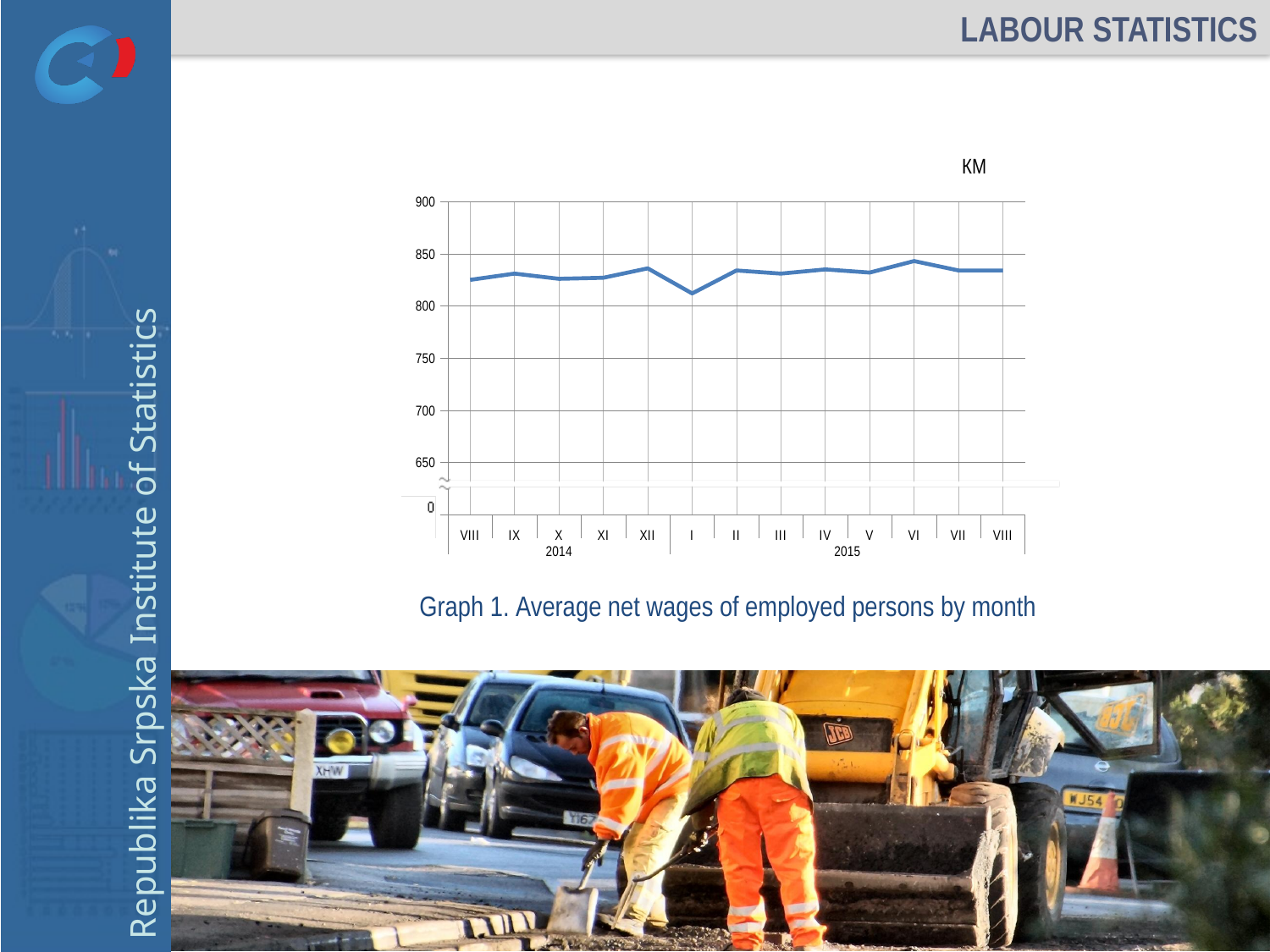
Is the value for VIII 2014 greater or less than 850? less What is the title of the chart? Graph 1. Average net wages of employed persons by month How many monthly points are plotted on the line? 13 What kind of chart is Graph 1? line chart Which is larger, the value for XII 2014 or the value for I 2015? XII 2014 Which month has the lowest average net wage? I 2015 Is the value for I 2015 greater or less than 850? less Does the line rise or fall from XII 2014 to I 2015? fall What unit is shown above the chart's y axis? KM Is the value for I 2015 greater or less than 800? greater Which month has the highest average net wage? VI 2015